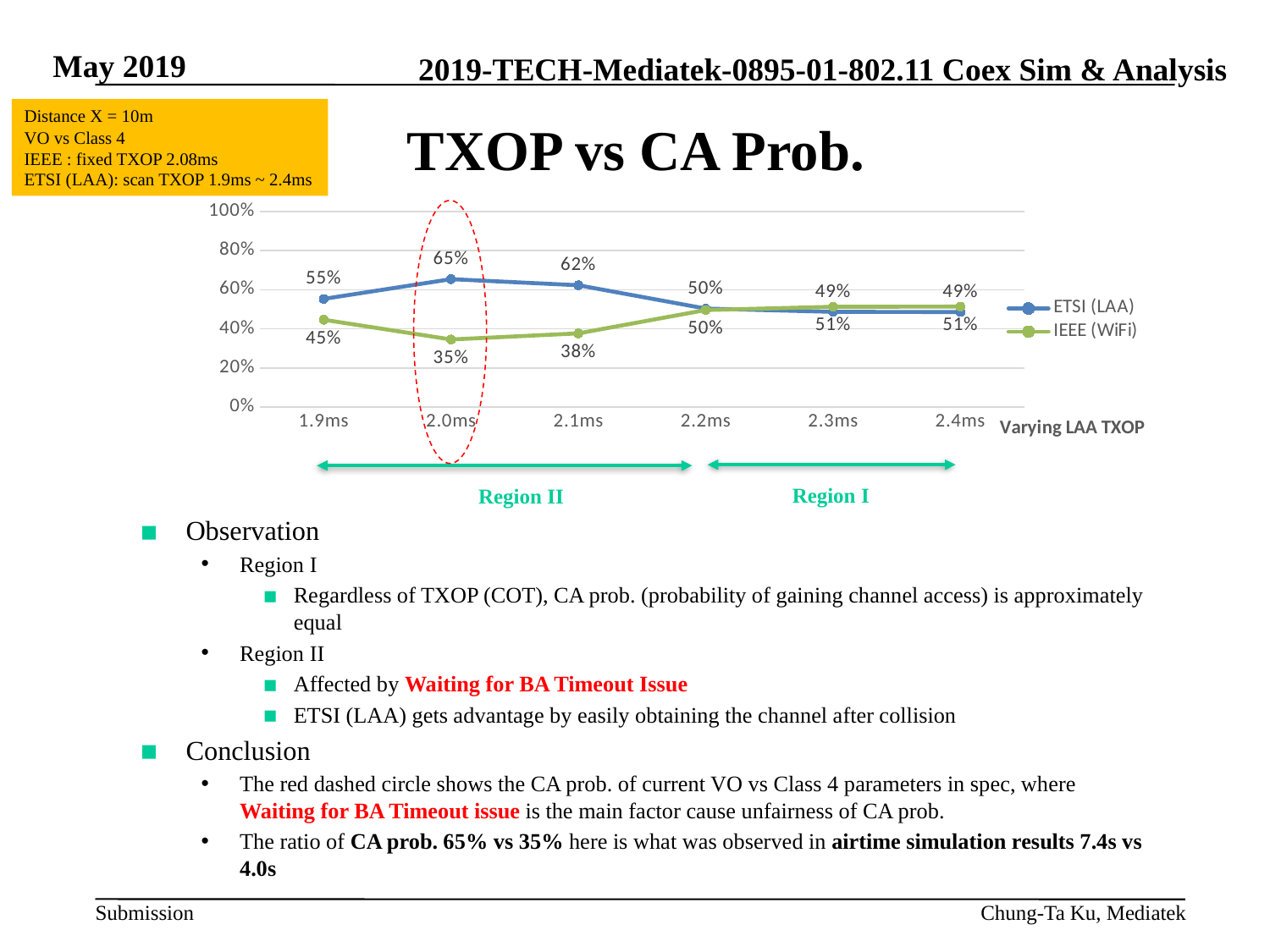
What is the CA probability for IEEE (WiFi) at 2.0ms? 35% What is the difference between the ETSI (LAA) and IEEE (WiFi) values at 2.0ms? 30% What is the value for IEEE (WiFi) at 2.1ms? 38% How many TXOP values are plotted along the x axis? 6 What is the CA probability for ETSI (LAA) at 2.0ms? 65% At 1.9ms, which series has the higher CA probability, ETSI (LAA) or IEEE (WiFi)? ETSI (LAA) At which TXOP value is the IEEE (WiFi) CA probability lowest? 2.0ms How many series does the legend list? 2 At which TXOP value does ETSI (LAA) reach its highest CA probability? 2.0ms What is the title of the chart? TXOP vs CA Prob. What type of chart is shown on the slide? line chart Does the IEEE (WiFi) line rise or fall from 2.0ms to 2.2ms? rise